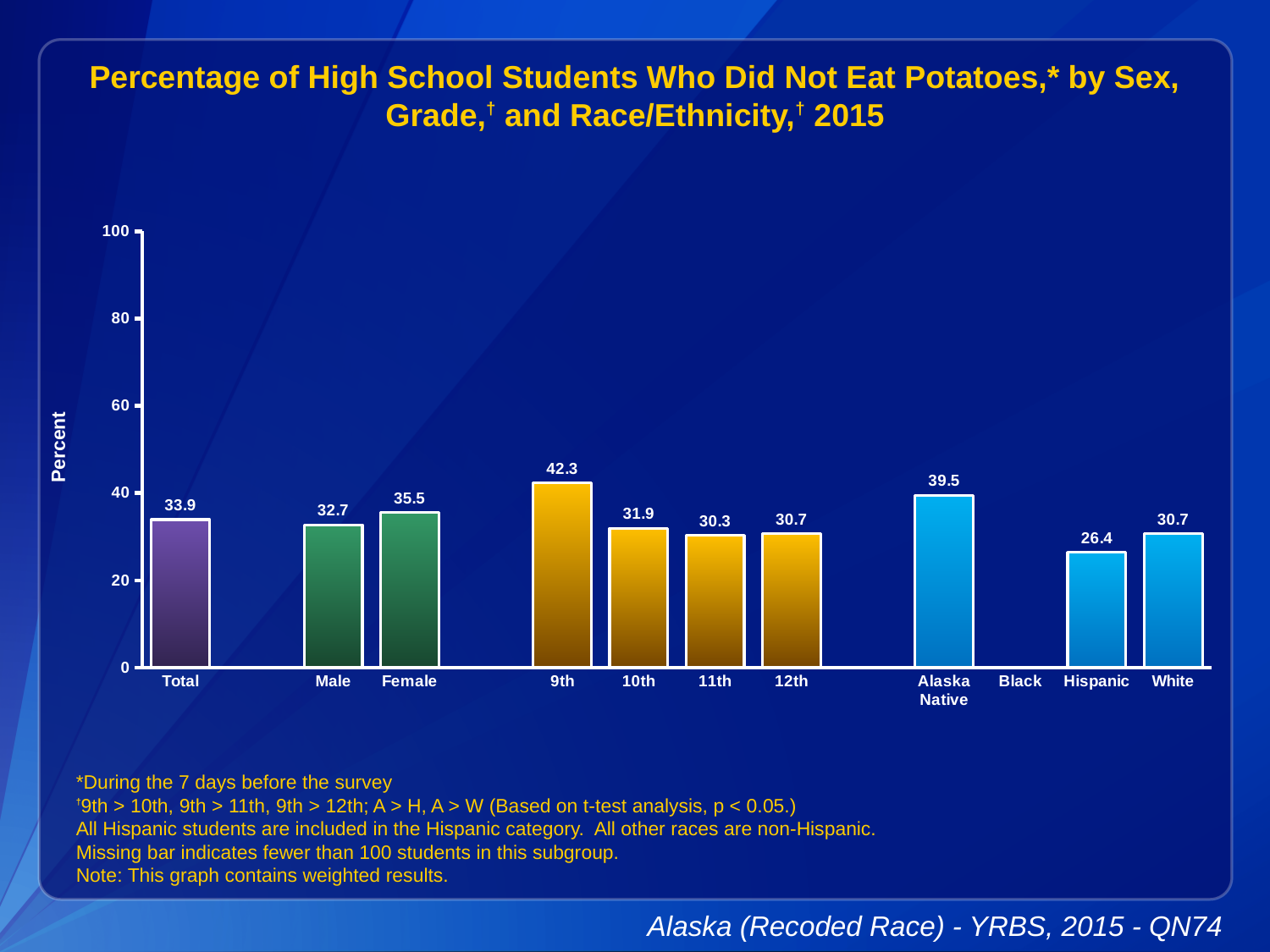
What is the difference between the Female and Male values? 2.8 What kind of chart is shown? bar chart What is the value for Total? 33.9 How many categories have a bar plotted? 10 Which category label has no bar? Black Which category with a bar has the lowest value? Hispanic Which is larger, the value for 10th grade or 11th grade? 10th What is the value for Alaska Native? 39.5 What is the value for 9th grade? 42.3 Which category has the highest value? 9th What is the value for Female? 35.5 Is the value for White greater or less than 40? less